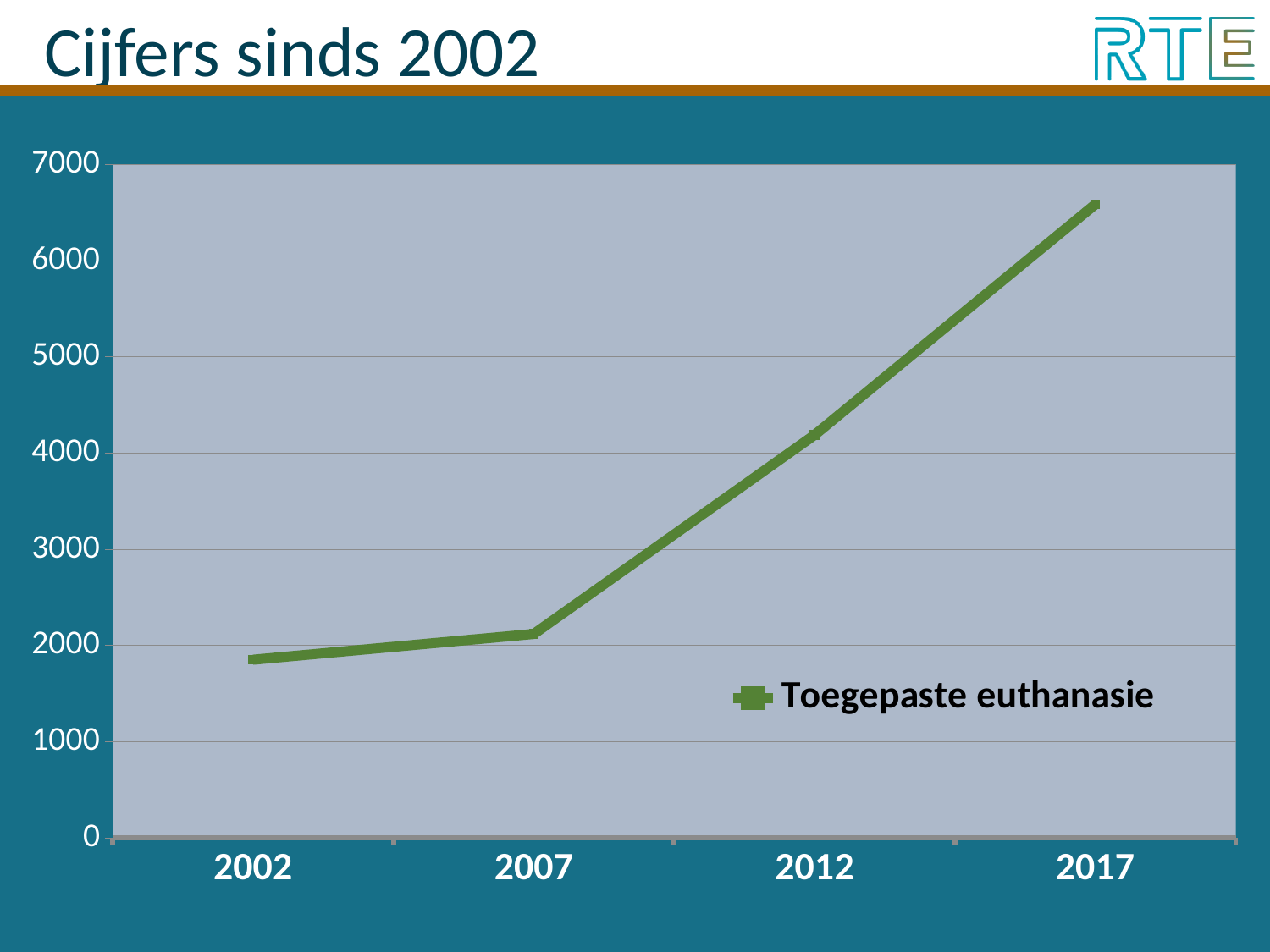
Is the value for Toegepaste euthanasie in 2002 greater or less than 2000? less Which year has the highest value for Toegepaste euthanasie? 2017 Is the value for Toegepaste euthanasie in 2012 greater or less than 4000? greater What is the name of the series shown in the legend? Toegepaste euthanasie Do the values for Toegepaste euthanasie rise or fall from 2002 to 2017? rise Which year has the lowest value for Toegepaste euthanasie? 2002 Which year has the larger value for Toegepaste euthanasie, 2007 or 2012? 2012 Is the value for Toegepaste euthanasie in 2017 greater or less than 6000? greater How many series does the legend list? 1 What kind of chart is shown on the slide? line chart What is the title of the slide containing the chart? Cijfers sinds 2002 How many years are plotted along the x axis? 4